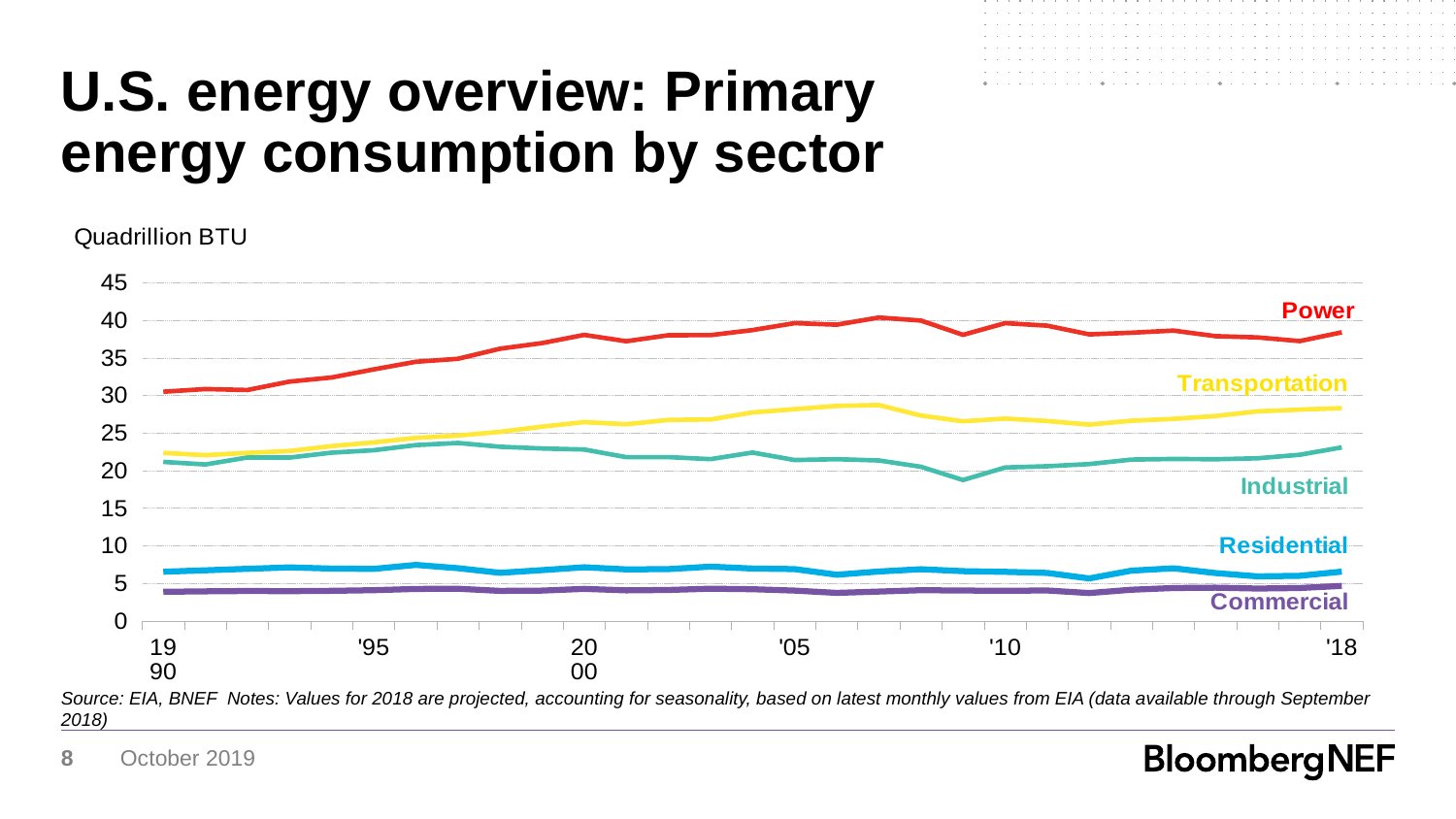
Which sector has the lowest primary energy consumption throughout the period shown? Commercial Is the value for Industrial around 2009 greater or less than 20? less In 2018, which is larger: Transportation or Industrial? Transportation How many sectors (series) are plotted on the chart? 5 What unit is the y axis measured in, according to the label above the chart? Quadrillion BTU Is the value for Power in 2000 greater or less than 35? greater What kind of chart is shown on the slide? Line chart Is the value for Power in 2018 greater or less than 40? less Which sector has the highest primary energy consumption throughout the period shown? Power Does the Power line rise or fall between 1990 and 2000? Rise